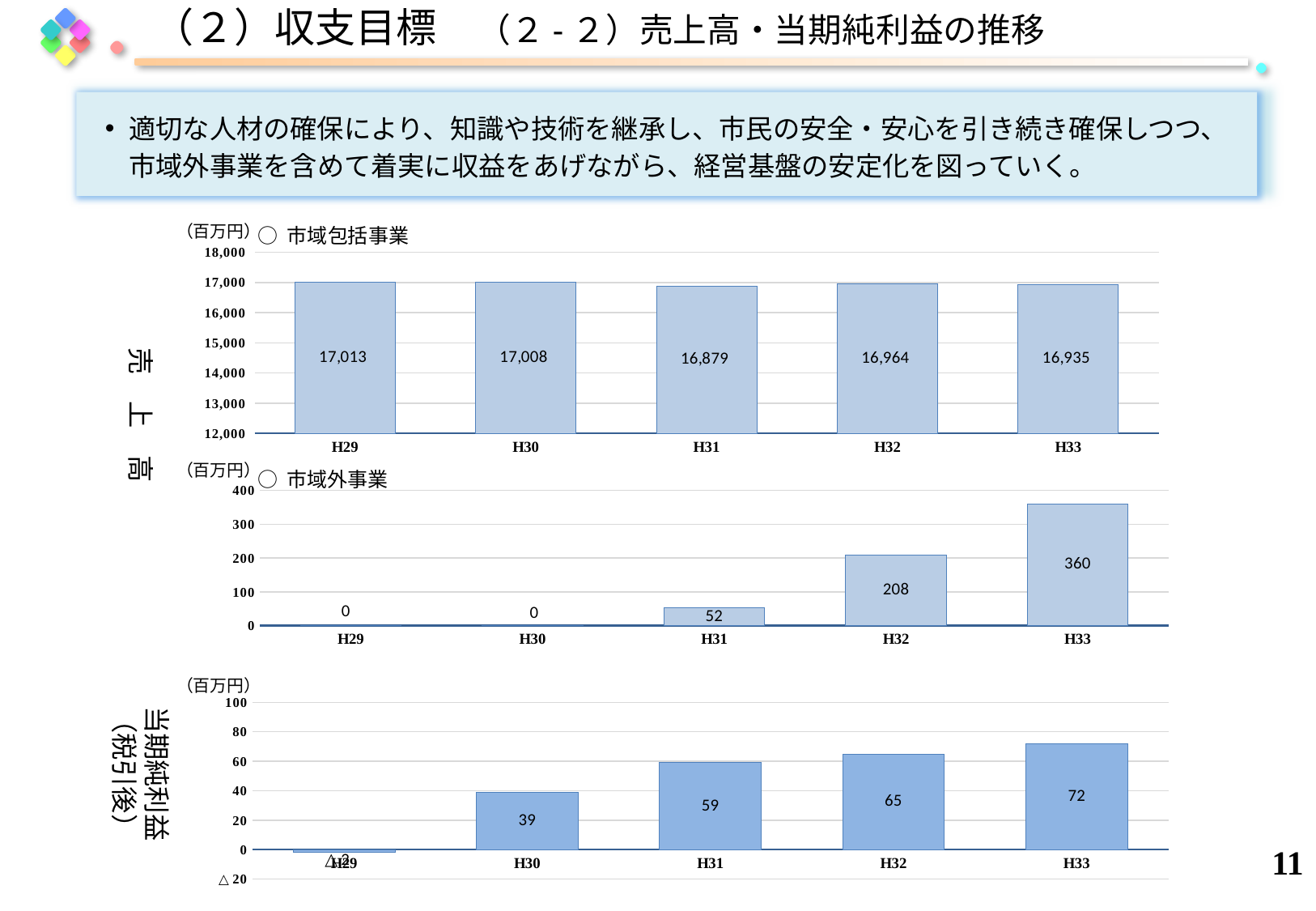
In the 市域包括事業 chart (top), what is the value for H31? 16,879 In the 市域外事業 chart (middle), do the values rise or fall from H29 to H33? rise What kind of chart is the 市域外事業 chart (middle)? bar chart In the 市域包括事業 chart (top), which year has the lowest value? H31 In the 市域外事業 chart (middle), what is the value for H32? 208 In the 市域外事業 chart (middle), what is the value for H33? 360 In the 当期純利益(税引後) chart (bottom), what is the value for H30? 39 In the 市域外事業 chart (middle), what is the difference between the H33 and H32 values? 152 In the 当期純利益(税引後) chart (bottom), which is larger, the value for H31 or H32? H32 In the 当期純利益(税引後) chart (bottom), which year has the highest value? H33 In the 市域包括事業 chart (top), which year has the highest value? H29 In the 市域包括事業 chart (top), what is the difference between the H29 and H30 values? 5